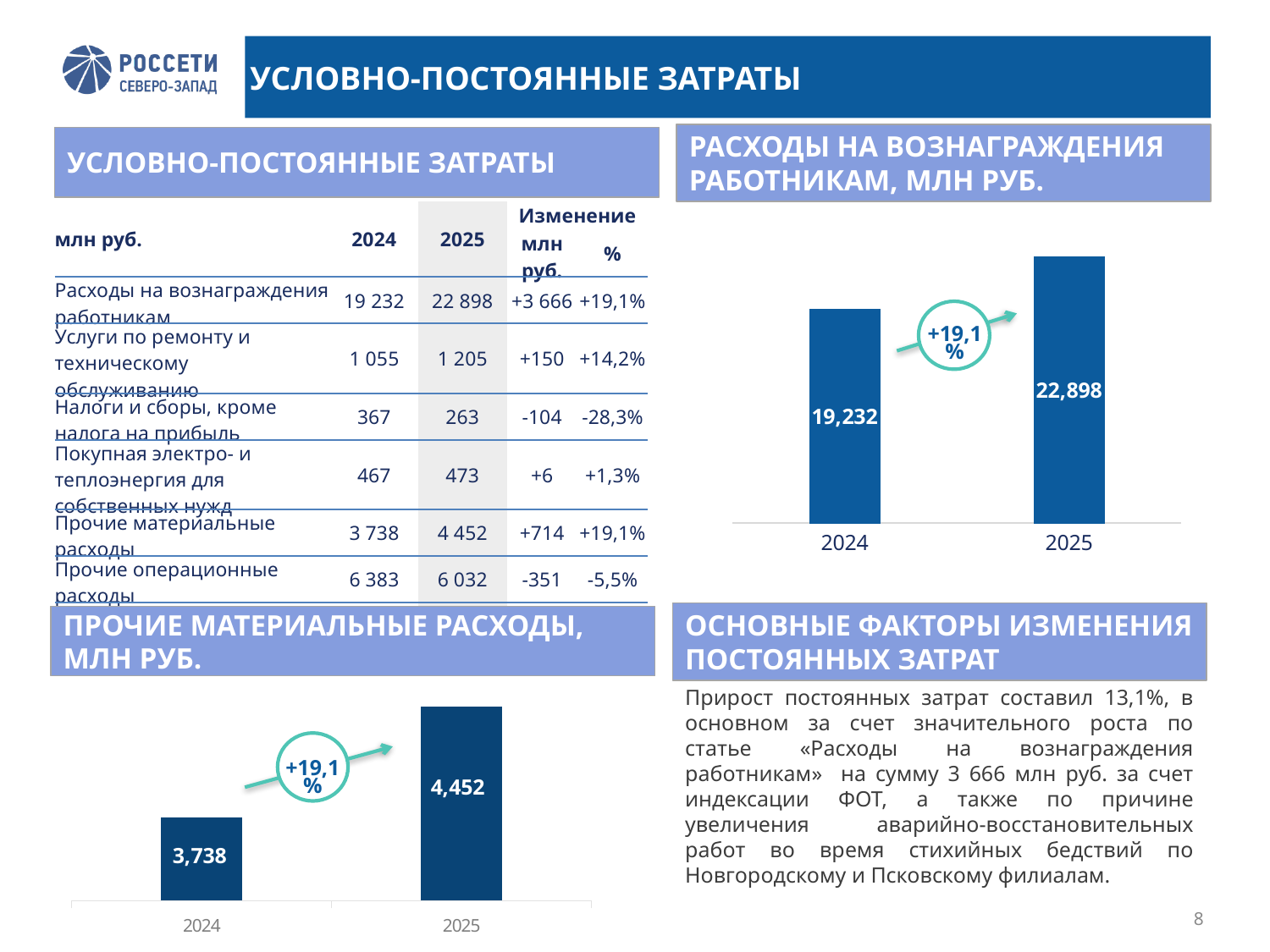
How many bars are shown in the chart titled 'РАСХОДЫ НА ВОЗНАГРАЖДЕНИЯ РАБОТНИКАМ, МЛН РУБ.'? 2 In the chart titled 'ПРОЧИЕ МАТЕРИАЛЬНЫЕ РАСХОДЫ, МЛН РУБ.', which year has the lower value? 2024 In the chart titled 'РАСХОДЫ НА ВОЗНАГРАЖДЕНИЯ РАБОТНИКАМ, МЛН РУБ.', which year has the higher value? 2025 In the chart titled 'РАСХОДЫ НА ВОЗНАГРАЖДЕНИЯ РАБОТНИКАМ, МЛН РУБ.', what is the value for 2024? 19,232 In the chart titled 'РАСХОДЫ НА ВОЗНАГРАЖДЕНИЯ РАБОТНИКАМ, МЛН РУБ.', what is the difference between the 2025 and 2024 values? 3,666 In the chart titled 'РАСХОДЫ НА ВОЗНАГРАЖДЕНИЯ РАБОТНИКАМ, МЛН РУБ.', what is the value for 2025? 22,898 What kind of chart is the one titled 'ПРОЧИЕ МАТЕРИАЛЬНЫЕ РАСХОДЫ, МЛН РУБ.'? bar chart In the chart titled 'РАСХОДЫ НА ВОЗНАГРАЖДЕНИЯ РАБОТНИКАМ, МЛН РУБ.', what percentage change is shown between 2024 and 2025? +19,1% In the chart titled 'ПРОЧИЕ МАТЕРИАЛЬНЫЕ РАСХОДЫ, МЛН РУБ.', what is the value for 2025? 4,452 In the chart titled 'ПРОЧИЕ МАТЕРИАЛЬНЫЕ РАСХОДЫ, МЛН РУБ.', do the values rise or fall from 2024 to 2025? rise In the chart titled 'ПРОЧИЕ МАТЕРИАЛЬНЫЕ РАСХОДЫ, МЛН РУБ.', what is the difference between the 2025 and 2024 values? 714 In the chart titled 'ПРОЧИЕ МАТЕРИАЛЬНЫЕ РАСХОДЫ, МЛН РУБ.', what is the value for 2024? 3,738